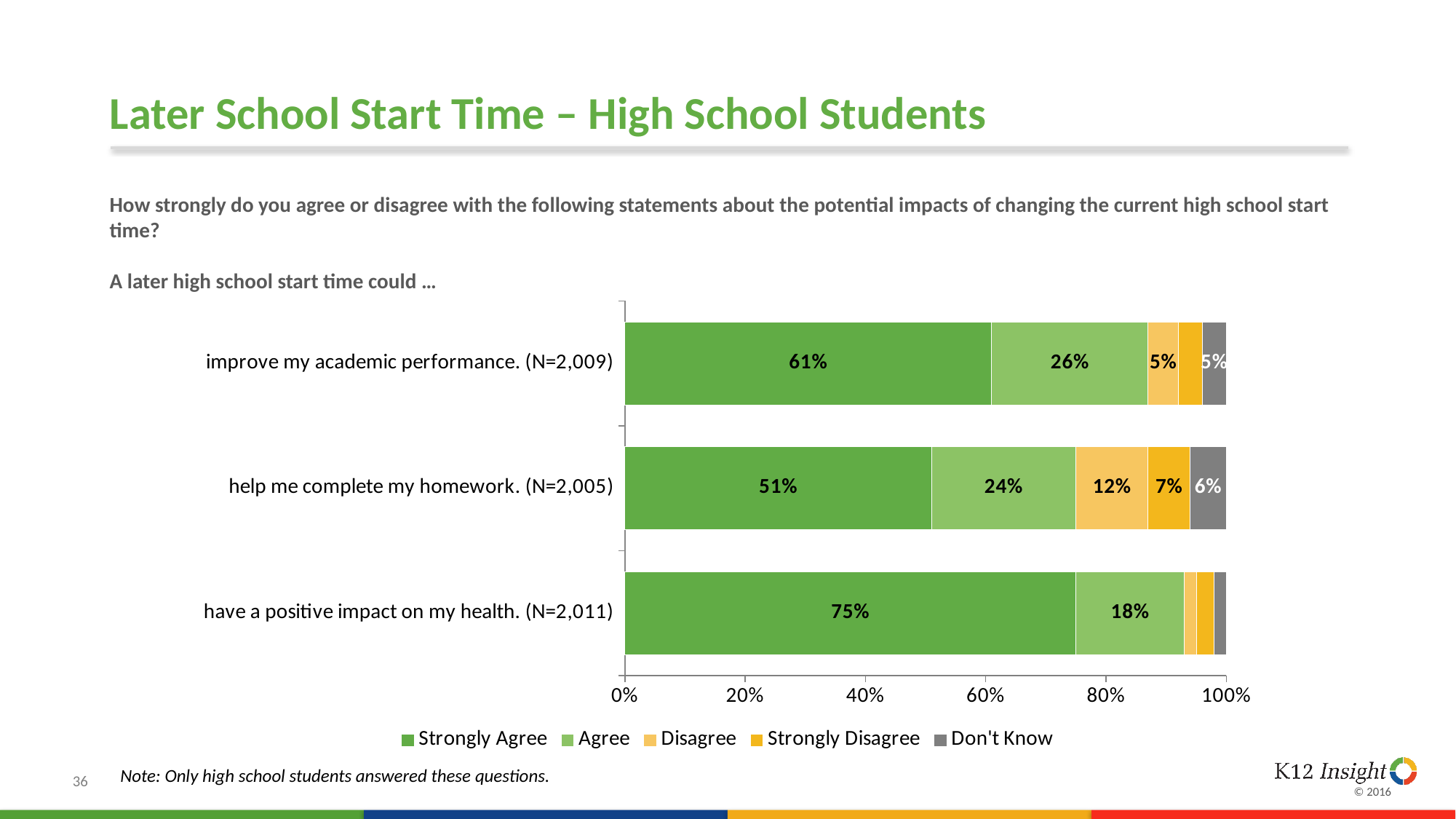
What percentage of students disagree that a later start time could help them complete their homework? 12% Which statement has the lowest Strongly Agree percentage? help me complete my homework. (N=2,005) What is the difference between the Strongly Agree values for "have a positive impact on my health" and "help me complete my homework"? 24% How many series does the legend list? 5 Which statement has the highest Strongly Agree percentage? have a positive impact on my health. (N=2,011) Is the Agree value larger for "improve my academic performance" or for "have a positive impact on my health"? improve my academic performance How many statements are shown in the chart? 3 What is the Strongly Agree value for "improve my academic performance"? 61% What type of chart is shown on the slide? Stacked bar chart What is the Don't Know value for "help me complete my homework"? 6% What is the Agree value for "help me complete my homework"? 24% What percentage of high school students strongly agree that a later start time could have a positive impact on their health? 75%